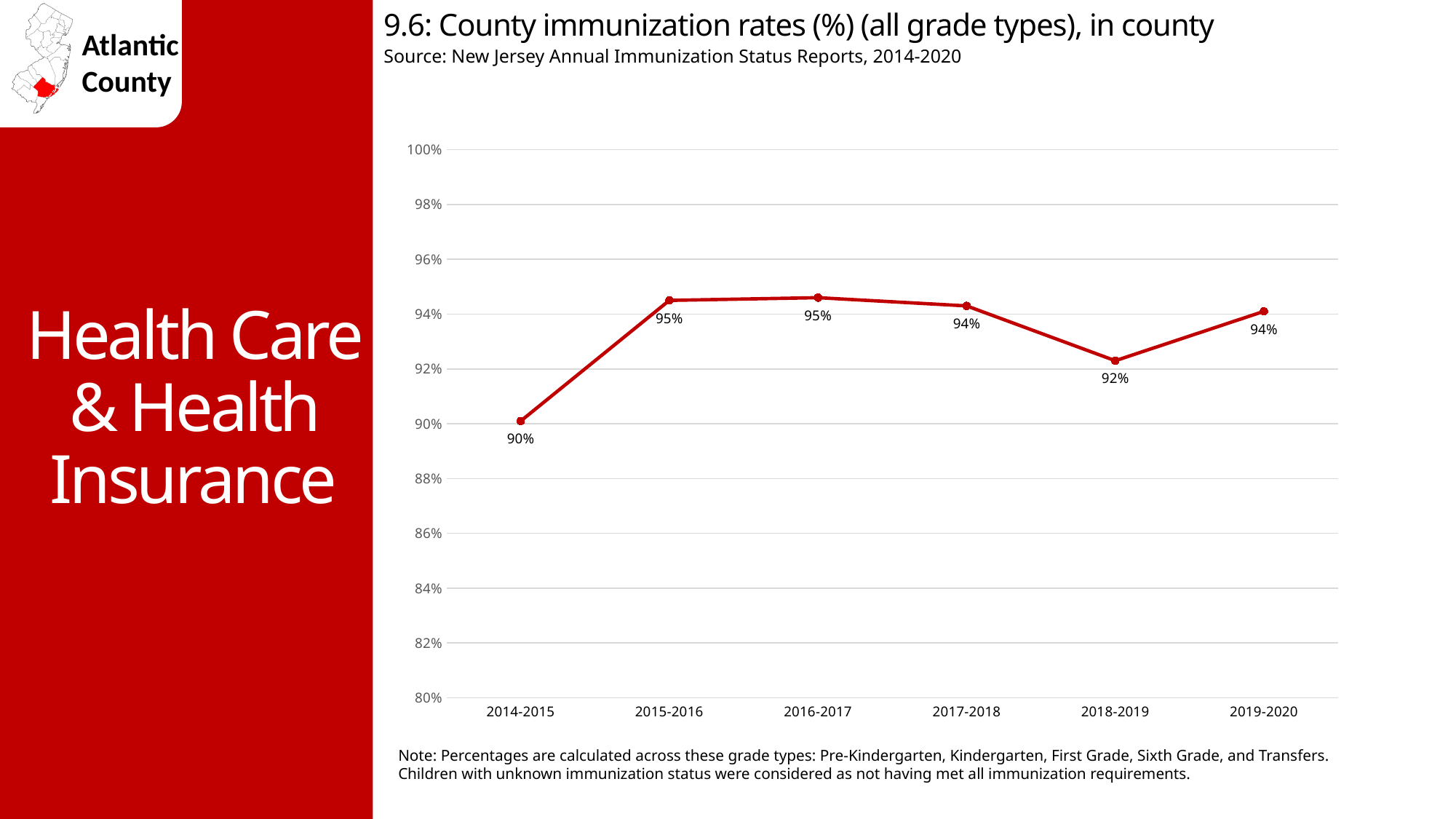
What is the county immunization rate for 2017-2018? 94% Is the immunization rate for 2014-2015 greater or less than 92%? less Does the immunization rate rise or fall from 2017-2018 to 2018-2019? fall Which has a higher immunization rate, 2017-2018 or 2018-2019? 2017-2018 What is the difference in immunization rate between 2018-2019 and 2014-2015? 2 percentage points What kind of chart is shown on the slide? line chart What is the county immunization rate for 2019-2020? 94% What is the source cited for the chart? New Jersey Annual Immunization Status Reports, 2014-2020 How many school years are plotted on the chart? 6 What is the county immunization rate for 2014-2015? 90% Which school year has the lowest immunization rate? 2014-2015 What is the county immunization rate for 2018-2019? 92%